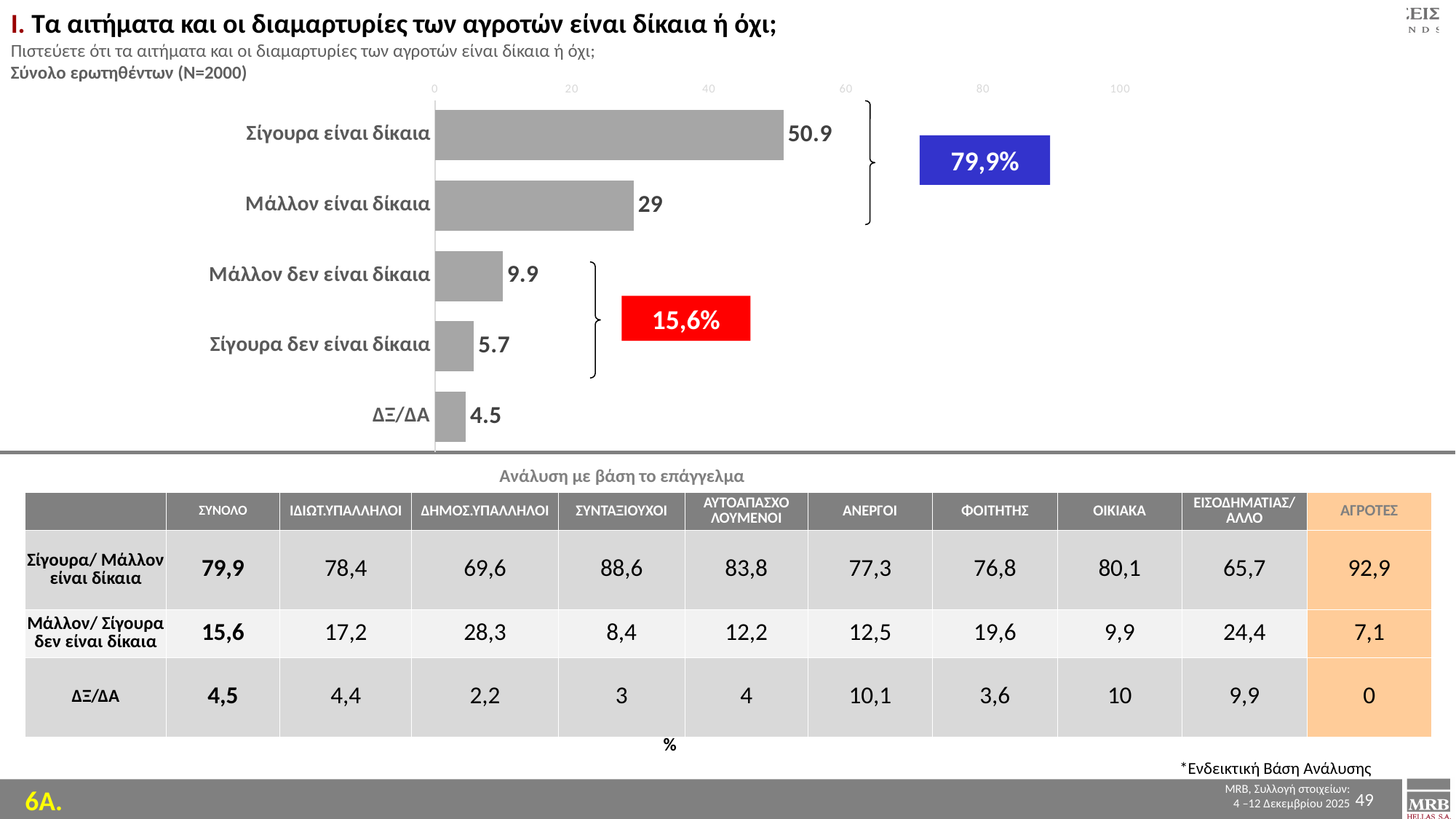
How many categories are shown in the bar chart? 5 Which category has the highest value in the bar chart? Σίγουρα είναι δίκαια What is the value for "ΔΞ/ΔΑ" in the bar chart? 4.5 Is the value for "Μάλλον είναι δίκαια" in the bar chart greater or less than 40? less What is the difference between the values for "Σίγουρα είναι δίκαια" and "Μάλλον είναι δίκαια" in the bar chart? 21.9 What is the value for "Σίγουρα δεν είναι δίκαια" in the bar chart? 5.7 What is the value for "Μάλλον είναι δίκαια" in the bar chart? 29 What is the value for "Σίγουρα είναι δίκαια" in the bar chart? 50.9 Which is larger in the bar chart: the value for "Μάλλον δεν είναι δίκαια" or the value for "Σίγουρα δεν είναι δίκαια"? Μάλλον δεν είναι δίκαια What kind of chart is shown on the slide? bar chart What combined percentage is shown in the blue box next to the bar chart? 79,9% Which category has the lowest value in the bar chart? ΔΞ/ΔΑ